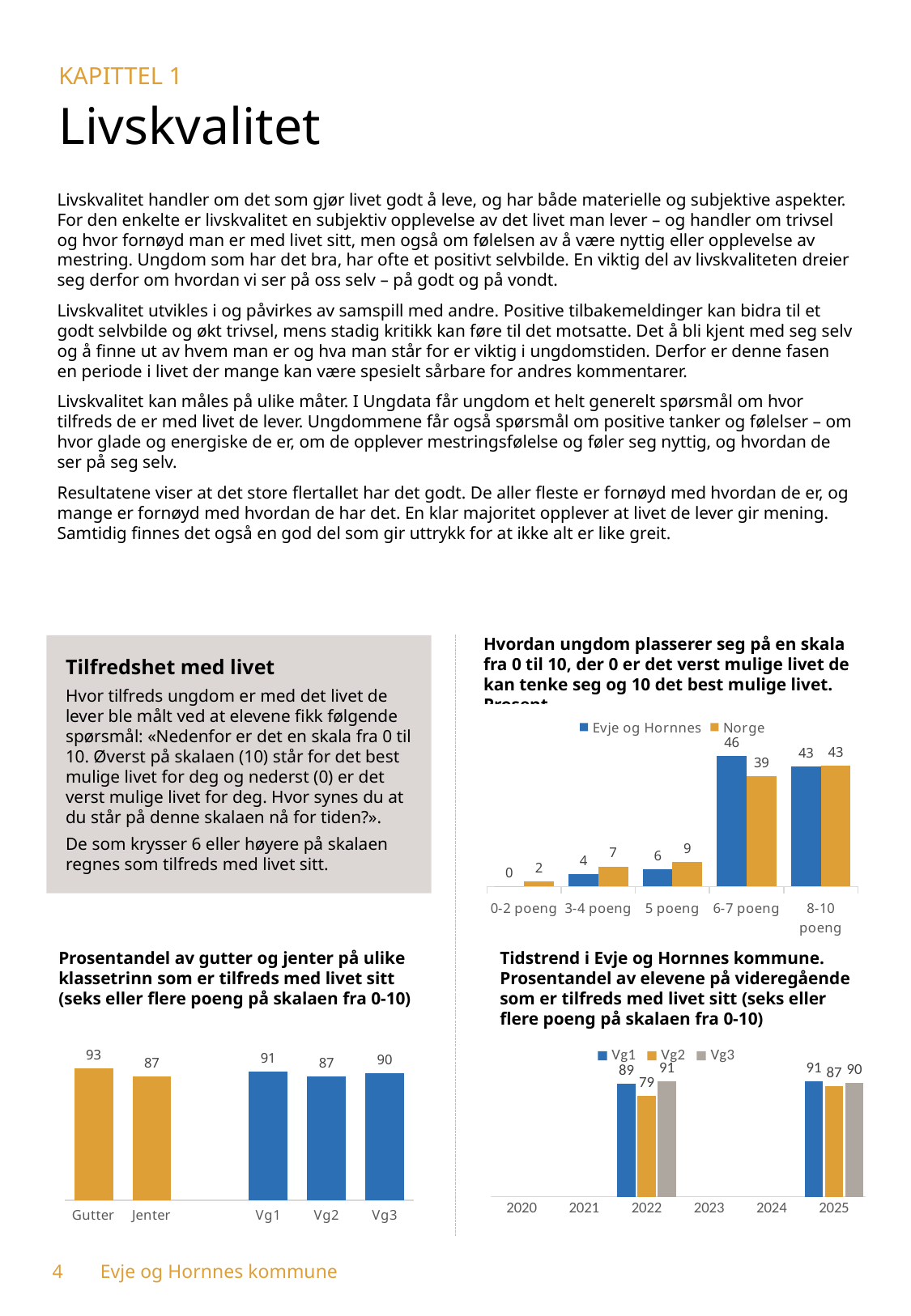
In the bottom-right chart (Tidstrend i Evje og Hornnes kommune), what is the value for Vg2 in 2022? 79 In the top-right chart (Hvordan ungdom plasserer seg på en skala fra 0 til 10), how many series does the legend list? 2 In the bottom-left chart (Prosentandel av gutter og jenter på ulike klassetrinn som er tilfreds med livet sitt), what is the difference between Gutter and Jenter? 6 In the top-right chart (Hvordan ungdom plasserer seg på en skala fra 0 til 10), what is the difference between Evje og Hornnes and Norge in the 6-7 poeng category? 7 In the bottom-right chart (Tidstrend i Evje og Hornnes kommune), which series has the lowest value in 2025? Vg2 In the top-right chart (Hvordan ungdom plasserer seg på en skala fra 0 til 10), what is the value for Evje og Hornnes in the 6-7 poeng category? 46 In the top-right chart (Hvordan ungdom plasserer seg på en skala fra 0 til 10), what is the value for Norge in the 3-4 poeng category? 7 In the top-right chart (Hvordan ungdom plasserer seg på en skala fra 0 til 10), which category has the highest value for Evje og Hornnes? 6-7 poeng In the bottom-left chart (Prosentandel av gutter og jenter på ulike klassetrinn som er tilfreds med livet sitt), what is the value for Gutter? 93 In the bottom-left chart (Prosentandel av gutter og jenter på ulike klassetrinn som er tilfreds med livet sitt), which is larger, Vg1 or Vg2? Vg1 In the top-right chart (Hvordan ungdom plasserer seg på en skala fra 0 til 10), how many categories are shown on the x axis? 5 What kind of chart is the bottom-right chart (Tidstrend i Evje og Hornnes kommune)? Bar chart